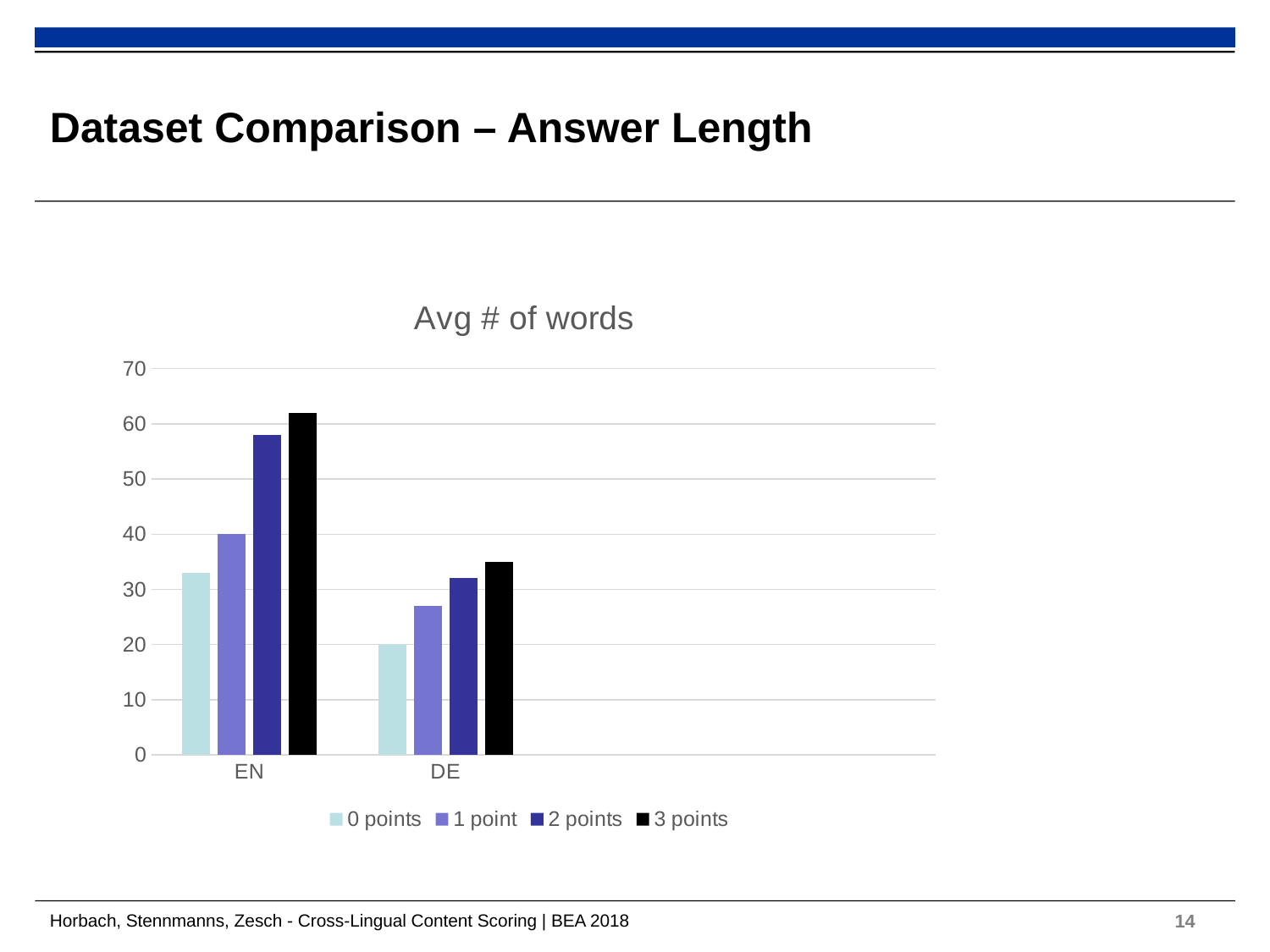
What kind of chart is shown on the slide? bar chart Is the value for 1 point in DE greater or less than 30? less What is the title of the chart? Avg # of words Which category and series has the lowest bar in the chart? DE, 0 points Is the value for 2 points in EN greater or less than 50? greater Is the value for 3 points in DE greater or less than 40? less How many categories are shown on the x axis? 2 Which category and series has the highest bar in the chart? EN, 3 points Which is larger: the 2 points value for EN or the 2 points value for DE? EN How many series does the legend list? 4 Within each category, do the bars rise or fall as the score goes from 0 points to 3 points? rise